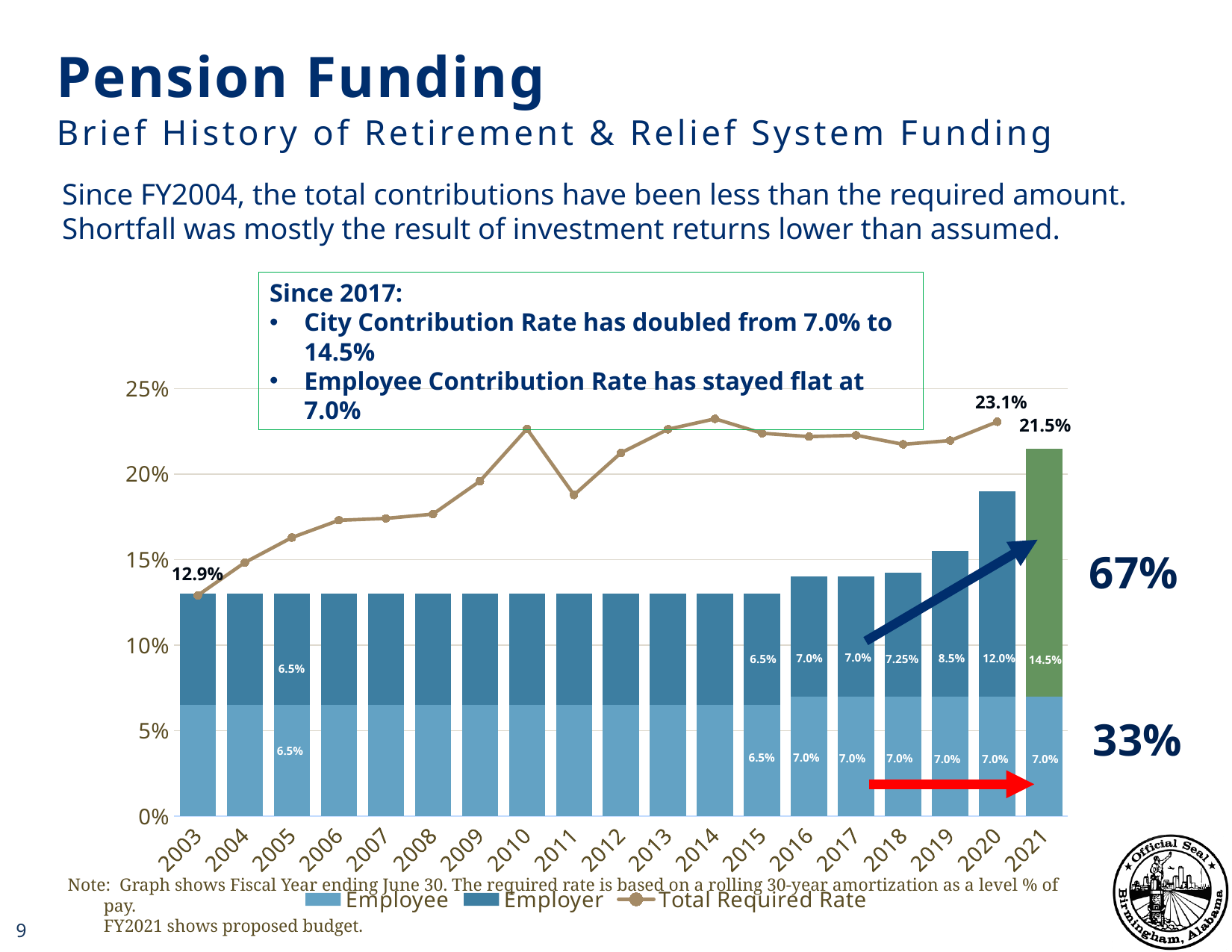
What is the Employer contribution rate for 2021? 14.5% What is the total contribution rate (Employee plus Employer) for 2021? 21.5% What is the Total Required Rate for 2003? 12.9% What is the Employee contribution rate for 2021? 7.0% What is the difference between the Employer contribution rate in 2021 and in 2020? 2.5% What is the Employer contribution rate for 2019? 8.5% How many years are shown on the x axis of the chart? 19 How many series does the chart legend list? 3 Which year has the highest Employer contribution rate? 2021 Is the Employer contribution rate larger in 2018 or in 2020? 2020 Is the Total Required Rate for 2010 greater or less than 20%? greater